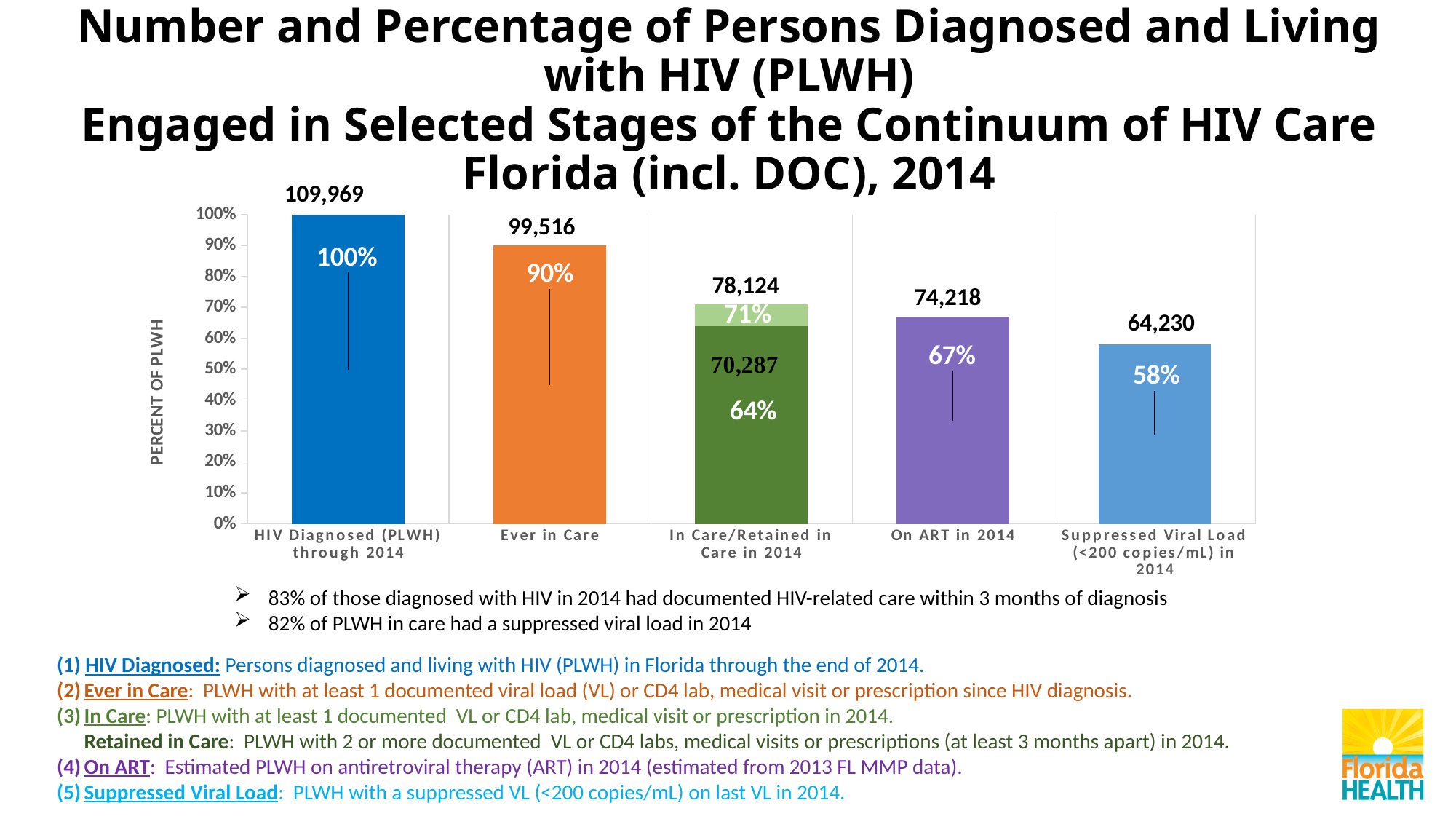
What number is shown for the Retained in Care portion (dark green) of the In Care/Retained in Care in 2014 bar? 70,287 Do the percentages rise or fall moving from left to right across the categories? Fall Which category has the lowest number of persons? Suppressed Viral Load (<200 copies/mL) in 2014 Which is larger, the number for On ART in 2014 or the number for Suppressed Viral Load in 2014? On ART in 2014 What number is shown for the On ART in 2014 bar? 74,218 What percentage is shown for the Suppressed Viral Load (<200 copies/mL) in 2014 bar? 58% What percentage is shown for the Ever in Care bar? 90% What percentage is shown at the top of the In Care/Retained in Care in 2014 bar? 71% What is the difference in number of persons between HIV Diagnosed (PLWH) through 2014 and Ever in Care? 10,453 What number is shown for the HIV Diagnosed (PLWH) through 2014 bar? 109,969 Which category has the highest percentage of PLWH? HIV Diagnosed (PLWH) through 2014 How many categories are shown on the x axis? 5